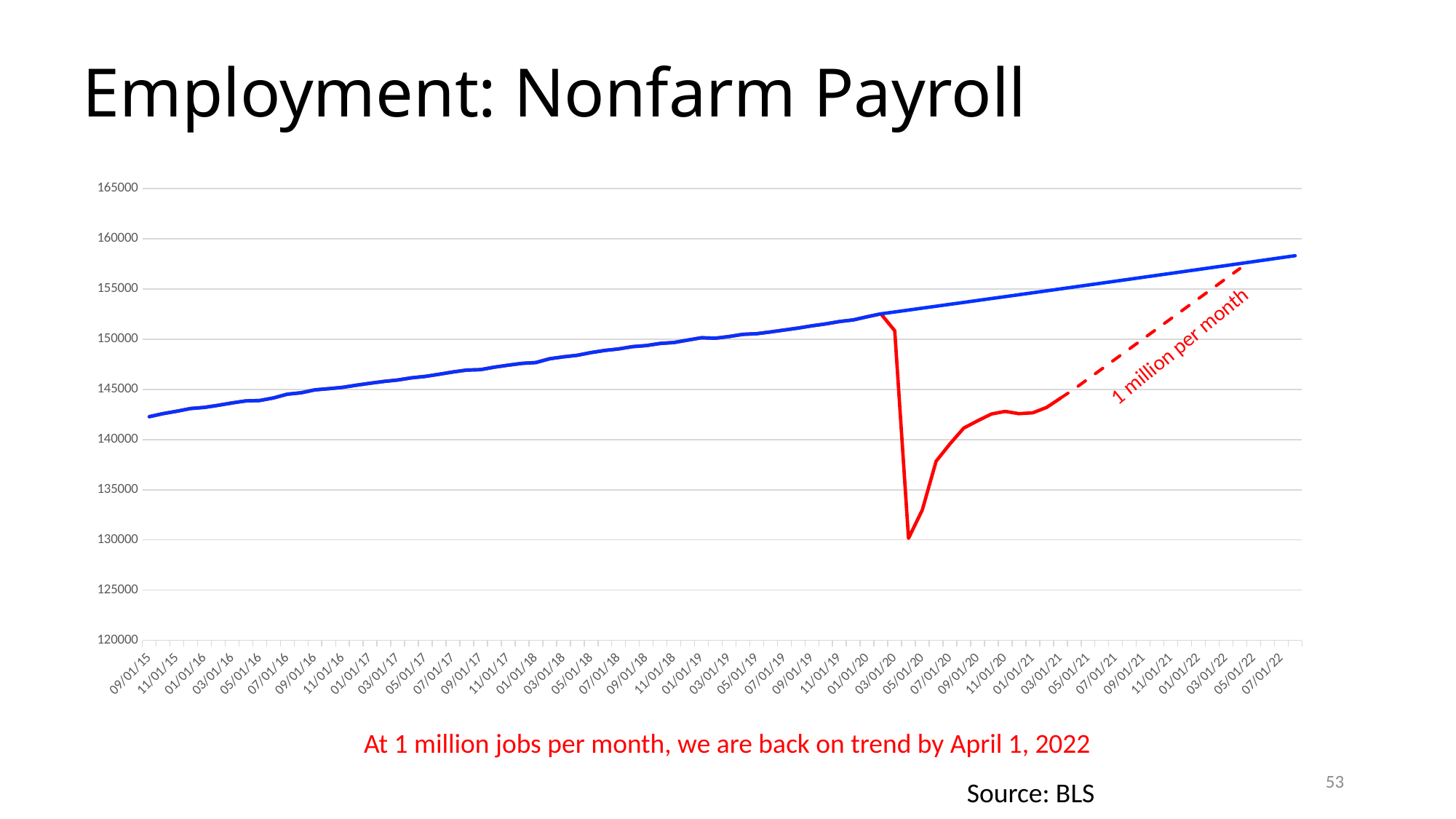
Is the lowest point of the red line greater or less than 135000? less Is the value of the blue line at 09/01/15 greater or less than 145000? less What does the red annotation along the dashed line say? 1 million per month Does the red line rise or fall between 03/01/20 and 05/01/20? fall Which line is higher at 07/01/20, the blue line or the red line? the blue line Is the value of the blue line at 07/01/22 greater or less than 155000? greater Does the blue line rise or fall from 09/01/15 to 07/01/22? rise What is the title of the slide containing the chart? Employment: Nonfarm Payroll What kind of chart is shown on the slide? line chart